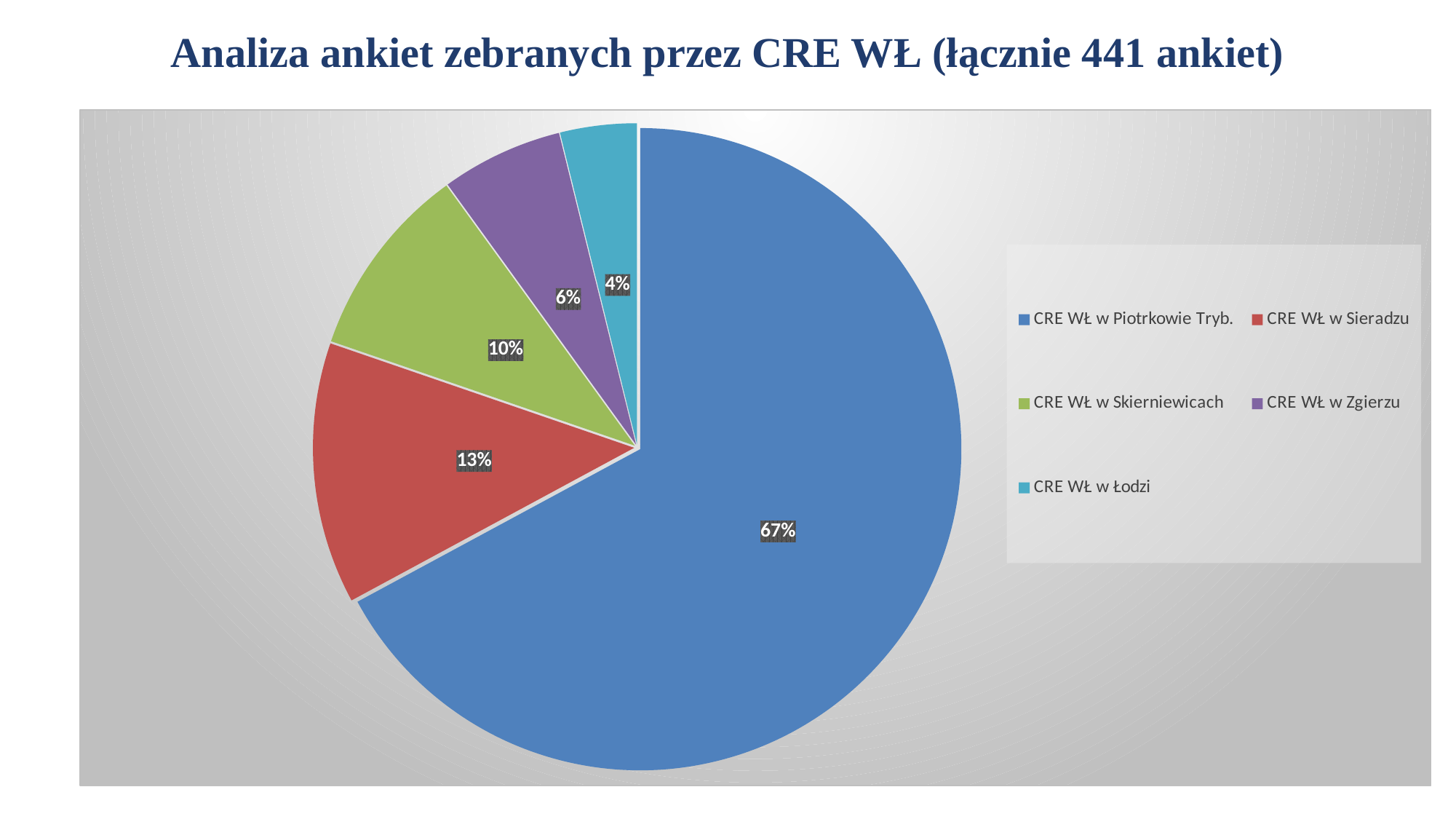
What share of the pie does CRE WŁ w Zgierzu have? 6% What share of the pie does CRE WŁ w Piotrkowie Tryb. have? 67% What share of the pie does CRE WŁ w Skierniewicach have? 10% What kind of chart is shown on the slide? Pie chart Which category has the smallest slice of the pie? CRE WŁ w Łodzi How many categories are shown in the pie chart? 5 What is the difference in percentage points between CRE WŁ w Sieradzu and CRE WŁ w Skierniewicach? 3% Which category has the largest slice of the pie? CRE WŁ w Piotrkowie Tryb. Which is larger, the share for CRE WŁ w Zgierzu or the share for CRE WŁ w Łodzi? CRE WŁ w Zgierzu What is the title of the chart? Analiza ankiet zebranych przez CRE WŁ (łącznie 441 ankiet)